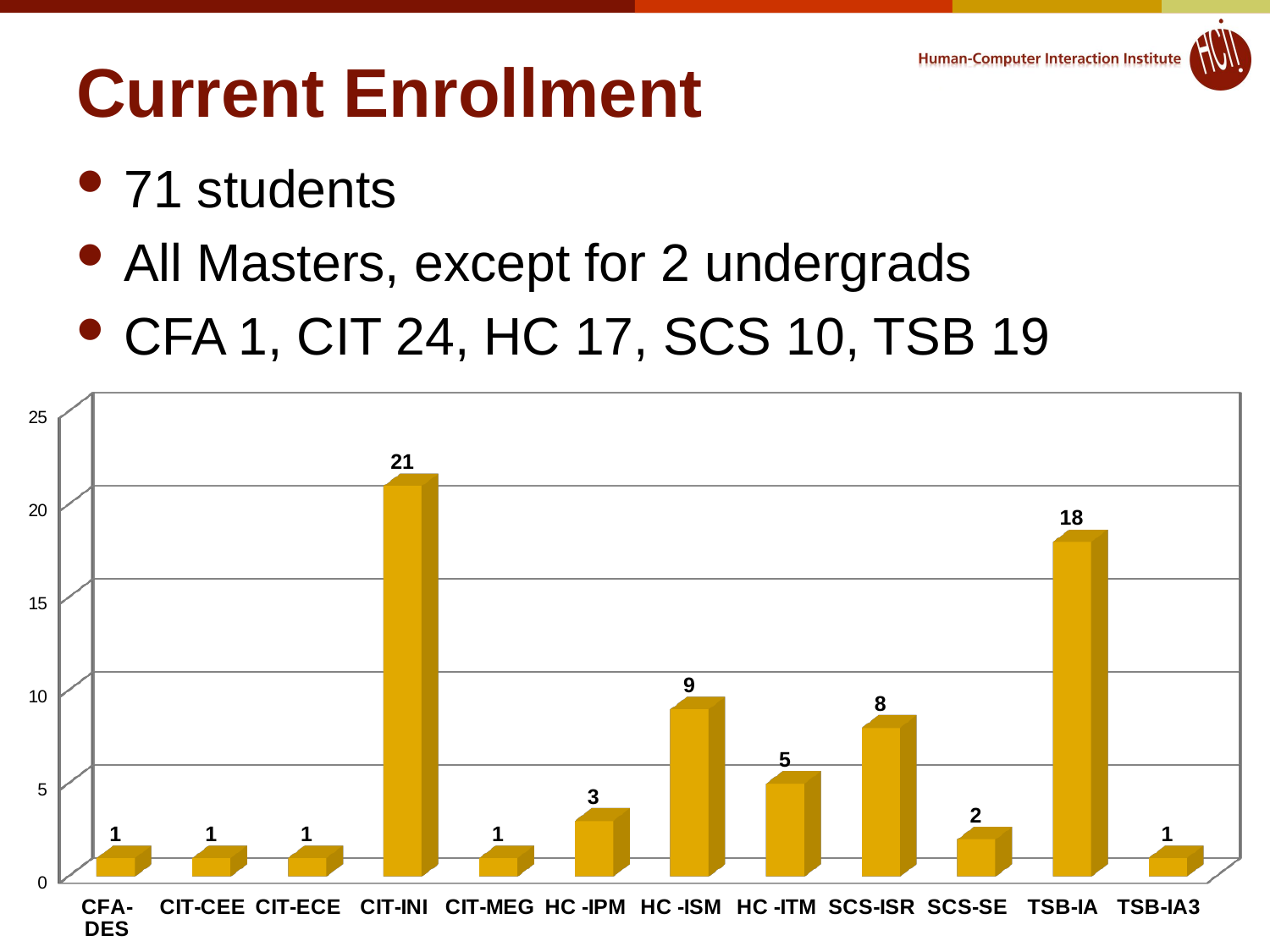
How many categories are shown on the x axis? 12 What is the difference between the values for CIT-INI and TSB-IA? 3 What is the value for TSB-IA? 18 What is the value for HC -ISM? 9 What is the value for SCS-SE? 2 What kind of chart is shown on the slide? bar chart Which category has the highest value? CIT-INI What is the value for CIT-INI? 21 Is the value for TSB-IA greater or less than 15? greater How many categories have a value of 1? 5 What is the difference between the values for HC -ISM and HC -ITM? 4 Which is larger, the value for SCS-ISR or the value for HC -IPM? SCS-ISR